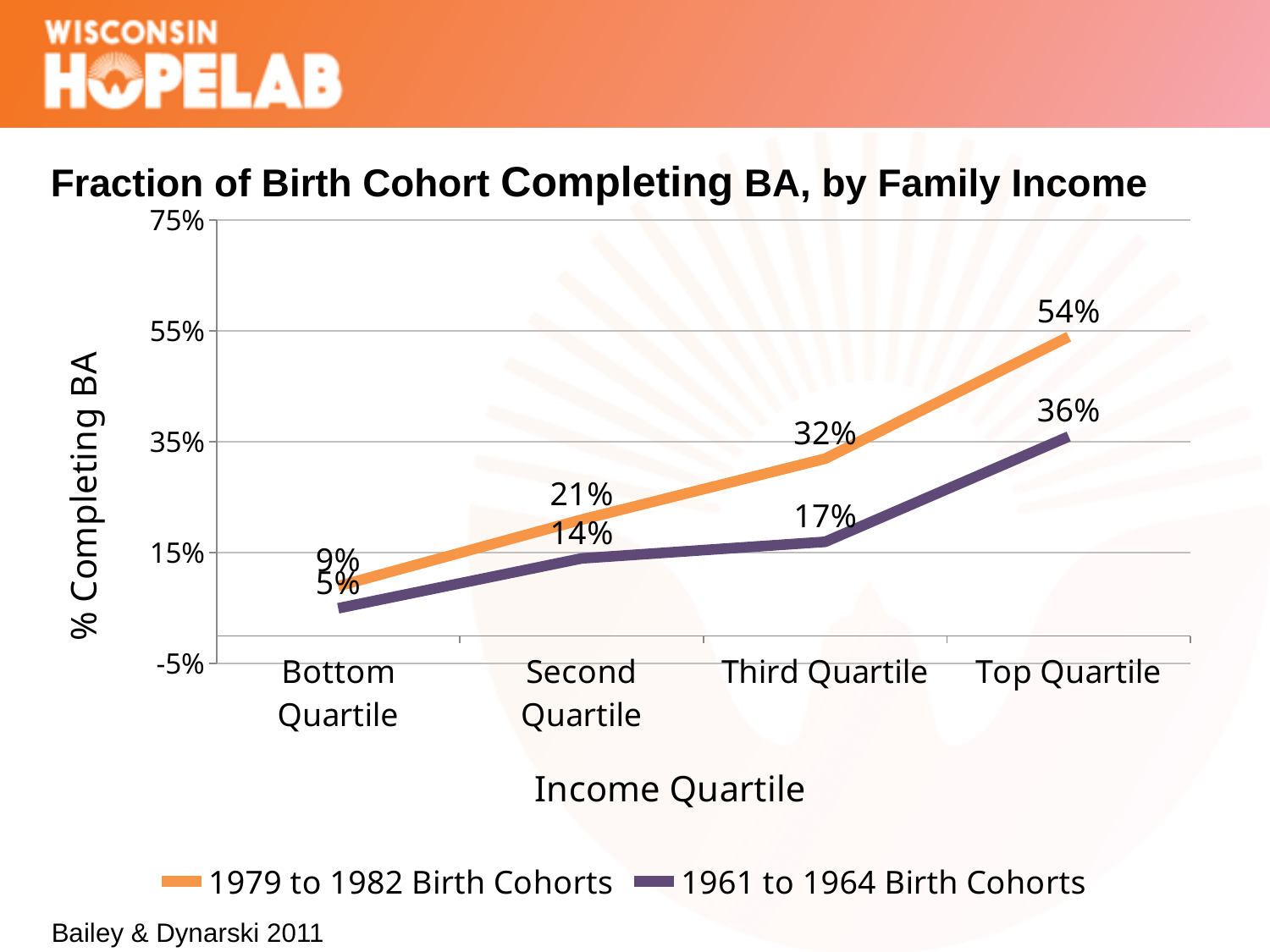
Do the values for the 1961 to 1964 Birth Cohorts series rise or fall from the Bottom Quartile to the Top Quartile? Rise Which income quartile has the highest value in the 1979 to 1982 Birth Cohorts series? Top Quartile Which is larger for the Third Quartile: the 1979 to 1982 Birth Cohorts value or the 1961 to 1964 Birth Cohorts value? 1979 to 1982 Birth Cohorts Which income quartile has the lowest value in the 1961 to 1964 Birth Cohorts series? Bottom Quartile How many income quartile categories are shown on the x axis? 4 What kind of chart is shown on the slide? Line chart What is the difference between the 1979 to 1982 and 1961 to 1964 Birth Cohorts values for the Top Quartile? 18% What is the value for the Bottom Quartile in the 1961 to 1964 Birth Cohorts series? 5% What is the value for the Second Quartile in the 1979 to 1982 Birth Cohorts series? 21% How many series does the legend list? 2 What is the value for the Top Quartile in the 1979 to 1982 Birth Cohorts series? 54% What is the value for the Third Quartile in the 1961 to 1964 Birth Cohorts series? 17%